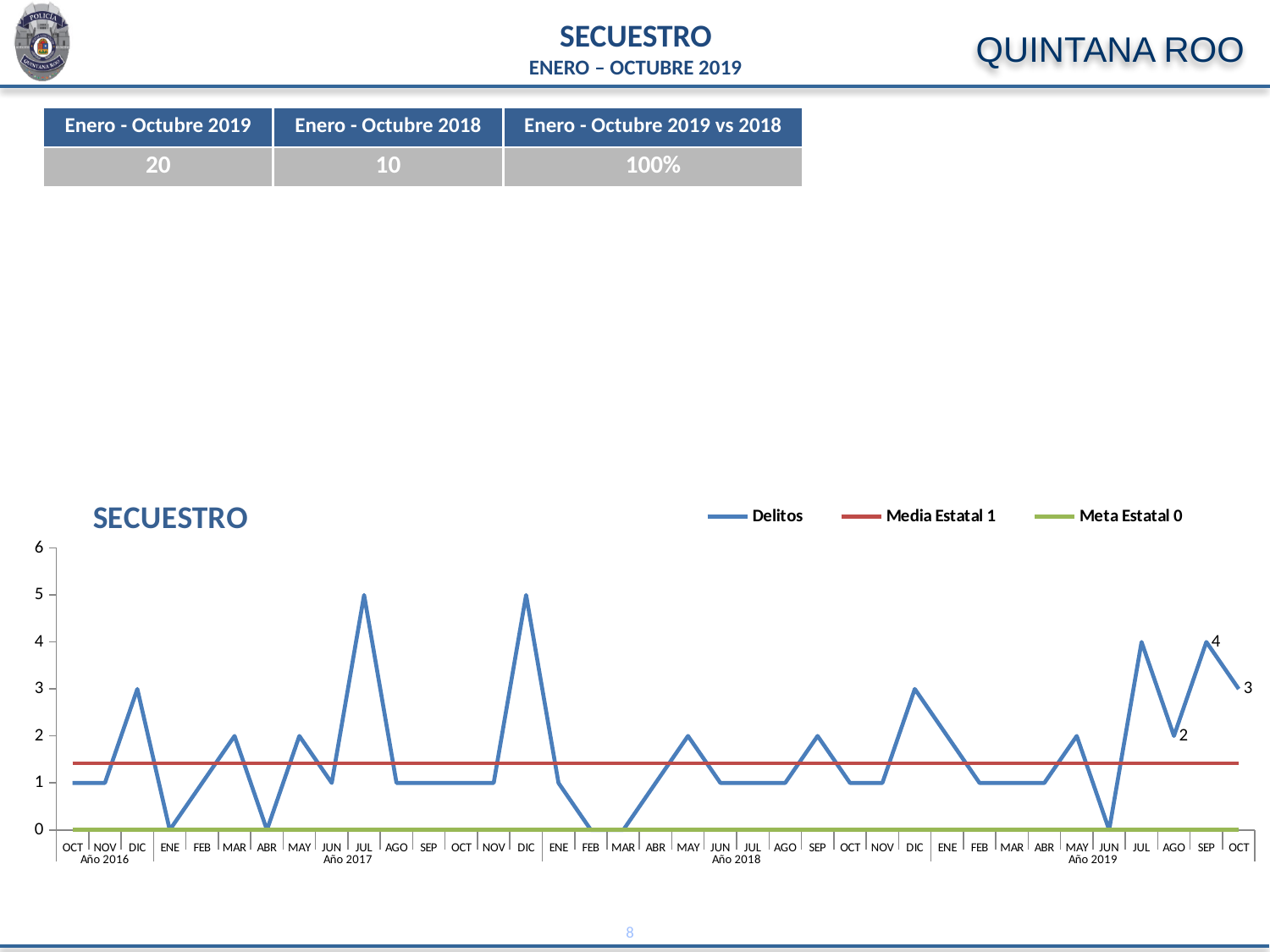
Which month has the larger Delitos value, SEP 2019 or OCT 2019? SEP 2019 What is the Delitos value for AGO of Año 2019? 2 What is the Delitos value for OCT of Año 2019? 3 Does the Delitos line rise or fall from AGO 2019 to SEP 2019? rises What is the Delitos value for SEP of Año 2019? 4 What is the difference between the Delitos values for SEP 2019 and AGO 2019? 2 What kind of chart is the SECUESTRO chart? line chart Is the Delitos value for JUL of Año 2017 greater or less than 4? greater What is the highest value the Delitos line reaches on the chart? 5 What is the Delitos value for JUN of Año 2019? 0 How many series does the legend of the SECUESTRO chart list? 3 What are the three legend entries of the SECUESTRO chart? Delitos, Media Estatal 1, Meta Estatal 0